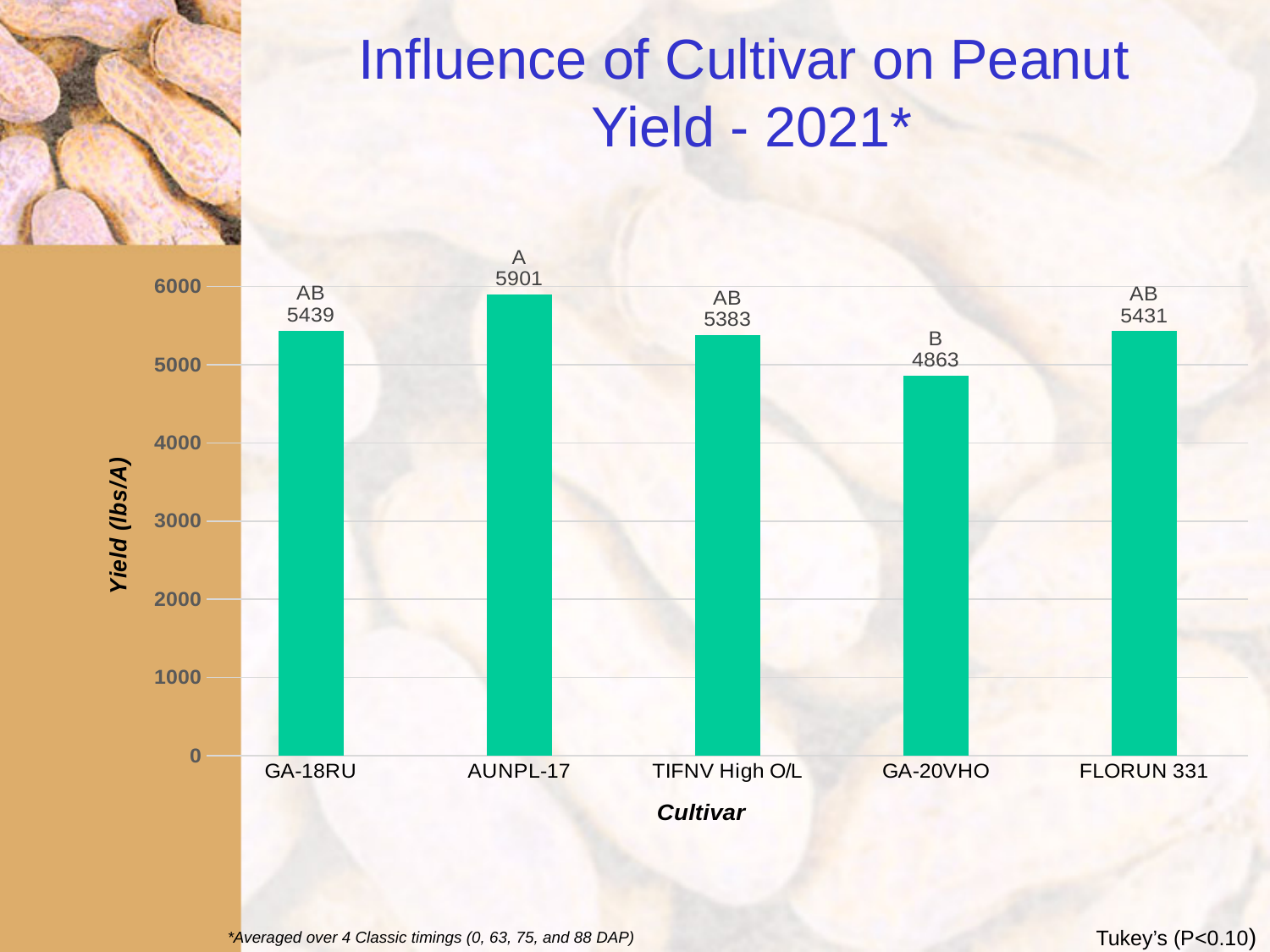
What is the difference in yield between AUNPL-17 and GA-20VHO? 1038 What is the yield for GA-20VHO? 4863 How many cultivars are shown in the chart? 5 What is the yield for AUNPL-17? 5901 Which cultivar has the highest yield? AUNPL-17 Which has a higher yield, AUNPL-17 or TIFNV High O/L? AUNPL-17 What kind of chart is shown on the slide? bar chart What is the yield for TIFNV High O/L? 5383 What is the difference in yield between GA-18RU and FLORUN 331? 8 Which cultivar has the lowest yield? GA-20VHO Is the yield for GA-20VHO greater or less than 5000? less What is the label of the y axis? Yield (lbs/A)